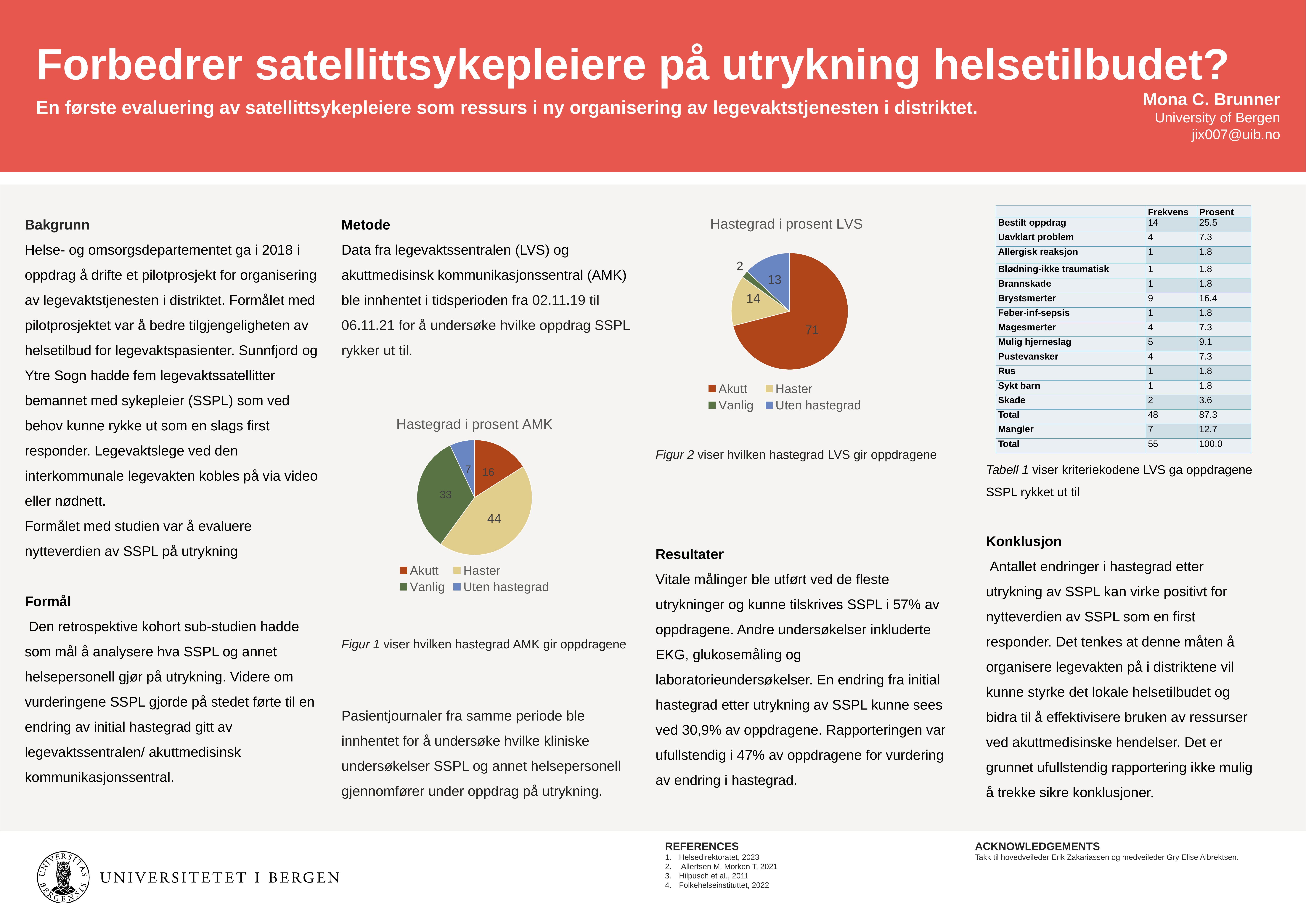
What kind of chart is 'Hastegrad i prosent AMK'? Pie chart In the 'Hastegrad i prosent AMK' chart, what is the value for Uten hastegrad? 7 In the 'Hastegrad i prosent AMK' chart, what is the value for Haster? 44 In the 'Hastegrad i prosent LVS' chart, which colour represents Akutt? Red In the 'Hastegrad i prosent LVS' chart, what is the value for Uten hastegrad? 13 How many categories does the 'Hastegrad i prosent LVS' chart show? 4 In the 'Hastegrad i prosent LVS' chart, which category has the smallest slice? Vanlig In the 'Hastegrad i prosent AMK' chart, what is the value for Vanlig? 33 In the 'Hastegrad i prosent AMK' chart, what is the difference between the values for Haster and Akutt? 28 In the 'Hastegrad i prosent AMK' chart, which category has the largest slice? Haster In the 'Hastegrad i prosent LVS' chart, which is larger, Haster or Uten hastegrad? Haster In the 'Hastegrad i prosent LVS' chart, what is the value for Akutt? 71